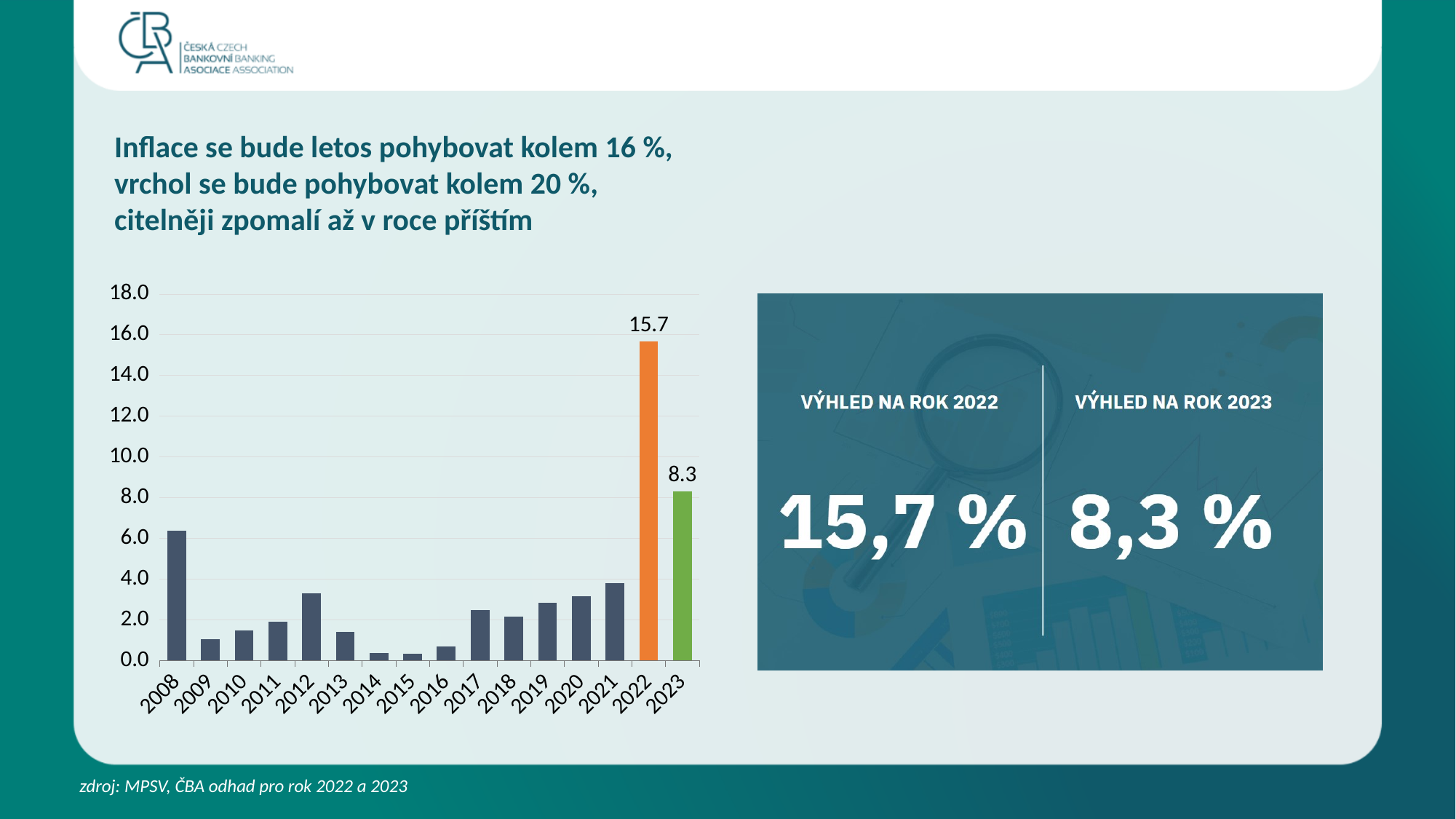
Is the value for 2012 greater or less than 2.0? greater Do the values rise or fall from 2017 to 2021? rise What kind of chart is shown on the slide? bar chart What is the value shown for 2023 in the bar chart? 8.3 What colour is the bar for 2022? orange Is the value for 2008 greater or less than 4.0? greater Which year has the larger value, 2008 or 2021? 2008 Which year has the highest bar in the chart? 2022 What is the value shown for 2022 in the bar chart? 15.7 How many years are shown on the x axis of the bar chart? 16 What is the difference between the values for 2022 and 2023? 7.4 Is the value for 2009 greater or less than 2.0? less